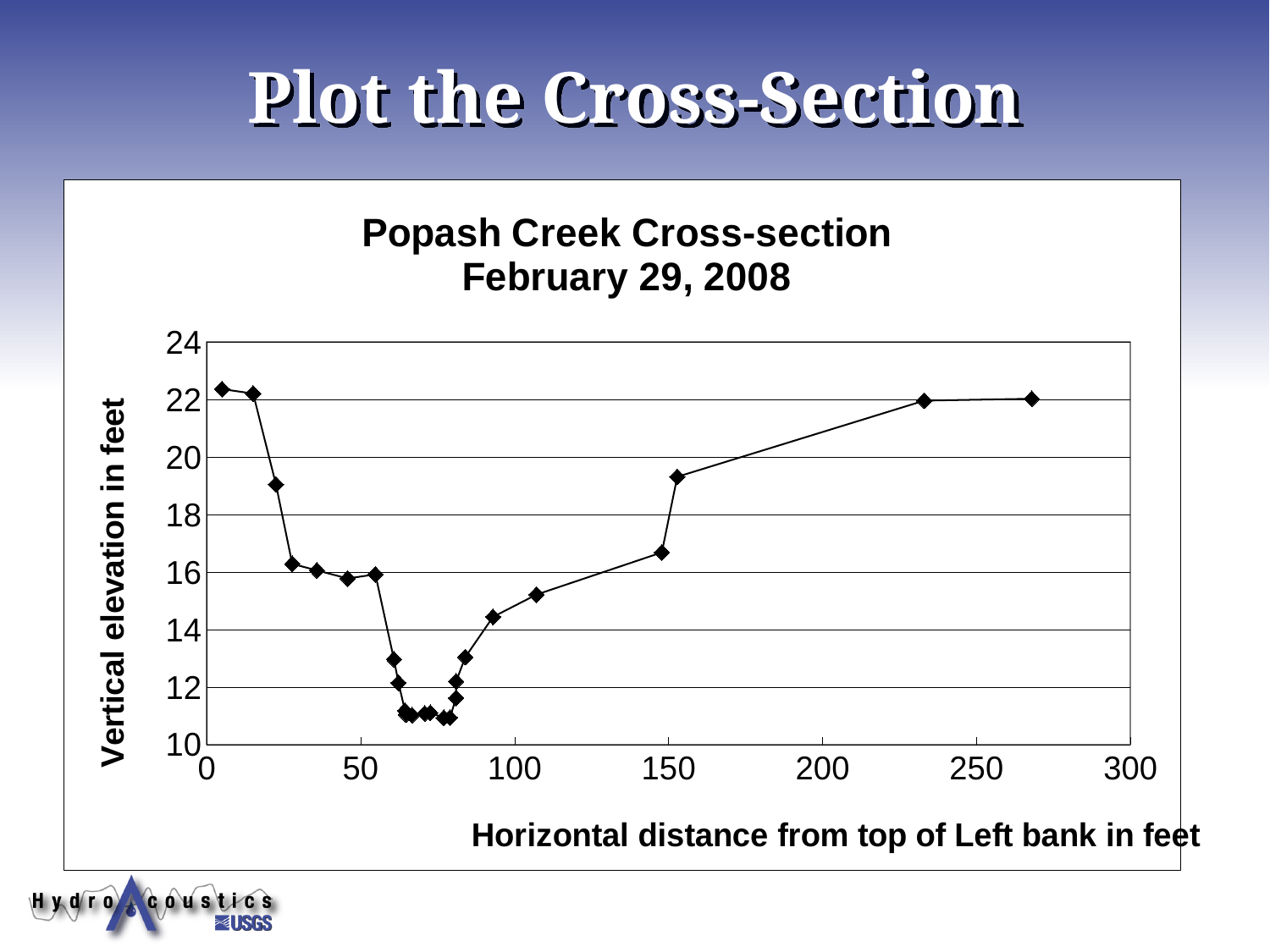
Do the elevation values rise or fall as horizontal distance increases from 0 to 50 feet? fall Is the lowest plotted elevation greater or less than 12 feet? less Do the elevation values rise or fall as horizontal distance increases from 100 to 250 feet? rise What is the label of the vertical axis? Vertical elevation in feet What kind of chart is shown on the slide? line chart What is the title of the chart? Popash Creek Cross-section February 29, 2008 Is the elevation at a horizontal distance of about 233 feet greater or less than 20 feet? greater Is the elevation at a horizontal distance of about 150 feet (the higher of the two points there) greater or less than 18 feet? greater Which is higher: the elevation at the first plotted point (near 0 feet) or the elevation at about 150 feet? the first plotted point (near 0 feet)